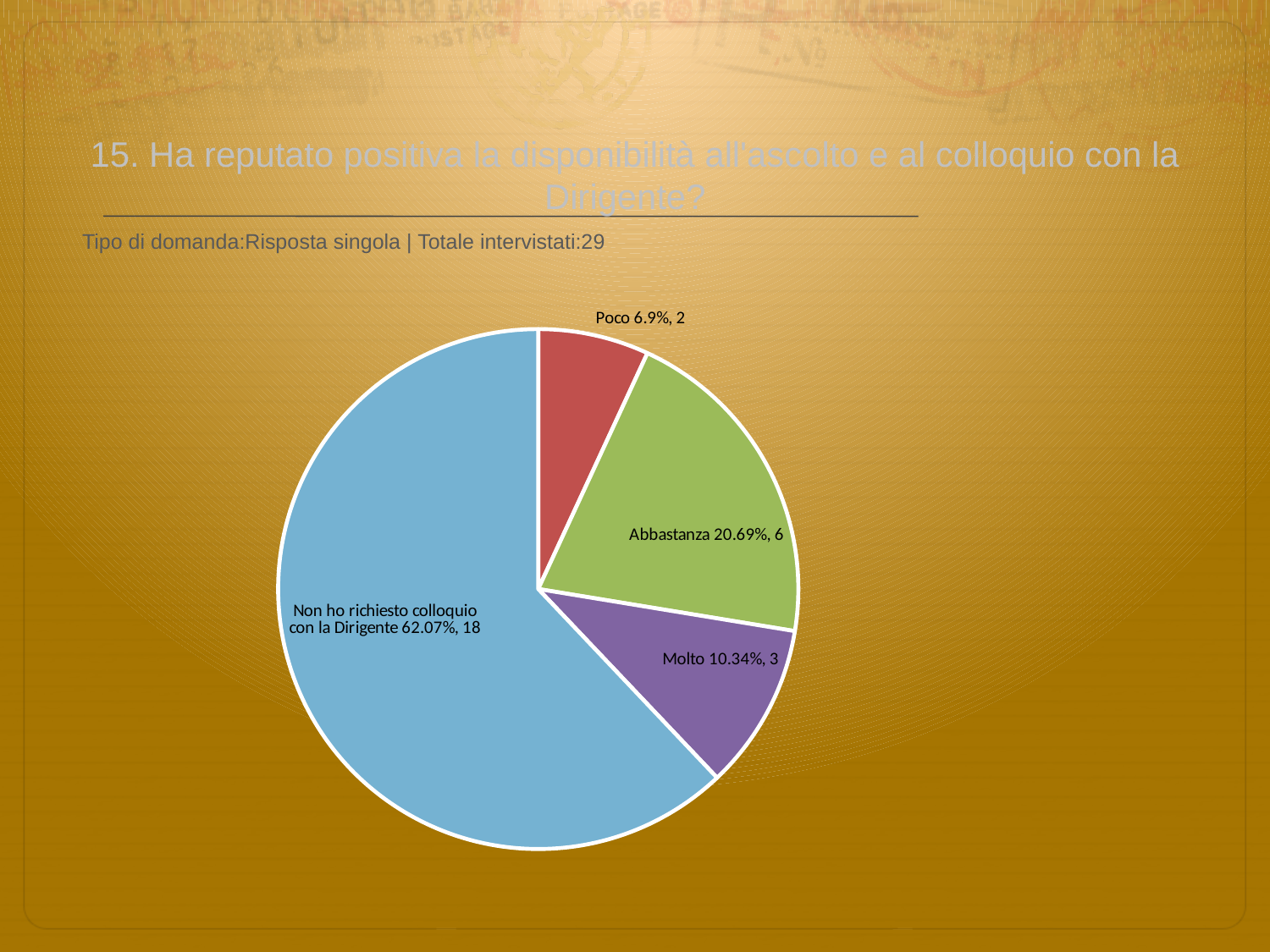
Which category has the smallest slice of the pie? Poco Which slice is larger, 'Abbastanza' or 'Poco'? Abbastanza How many slices does the pie chart have? 4 What kind of chart is shown on the slide? pie chart How many respondents chose 'Abbastanza'? 6 What percentage share does the 'Molto' slice have? 10.34% How many respondents chose 'Molto'? 3 What percentage share does the 'Non ho richiesto colloquio con la Dirigente' slice have? 62.07% Which category has the largest slice of the pie? Non ho richiesto colloquio con la Dirigente What percentage share does the 'Poco' slice have? 6.9% What is the difference in respondent count between 'Abbastanza' and 'Molto'? 3